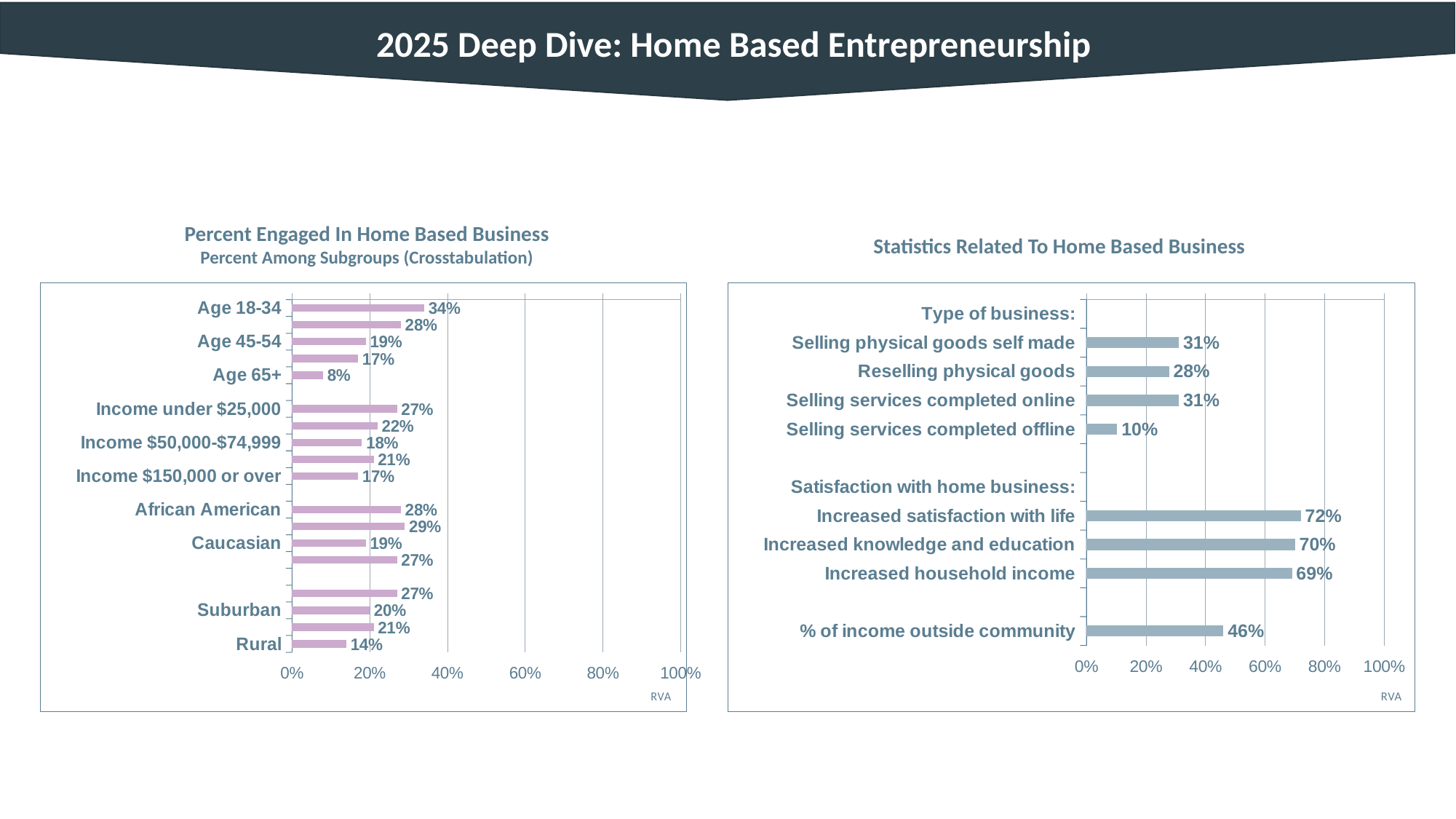
In the 'Percent Engaged In Home Based Business' chart, what is the value for Rural? 14% In the 'Statistics Related To Home Based Business' chart, what is the difference between Increased household income and % of income outside community? 23% In the 'Statistics Related To Home Based Business' chart, what is the value for Increased satisfaction with life? 72% In the 'Percent Engaged In Home Based Business' chart, what is the value for Age 18-34? 34% In the 'Percent Engaged In Home Based Business' chart, what is the value for Age 65+? 8% In the 'Percent Engaged In Home Based Business' chart, which is larger, African American or Caucasian? African American What kind of chart is the 'Statistics Related To Home Based Business' chart? Bar chart In the 'Percent Engaged In Home Based Business' chart, is the value for Income under $25,000 greater or less than 20%? greater In the 'Statistics Related To Home Based Business' chart, which category has the highest value? Increased satisfaction with life In the 'Percent Engaged In Home Based Business' chart, what is the difference between Age 18-34 and Age 65+? 26% In the 'Statistics Related To Home Based Business' chart, what is the value for Selling services completed offline? 10% In the 'Statistics Related To Home Based Business' chart, which category has the lowest value? Selling services completed offline